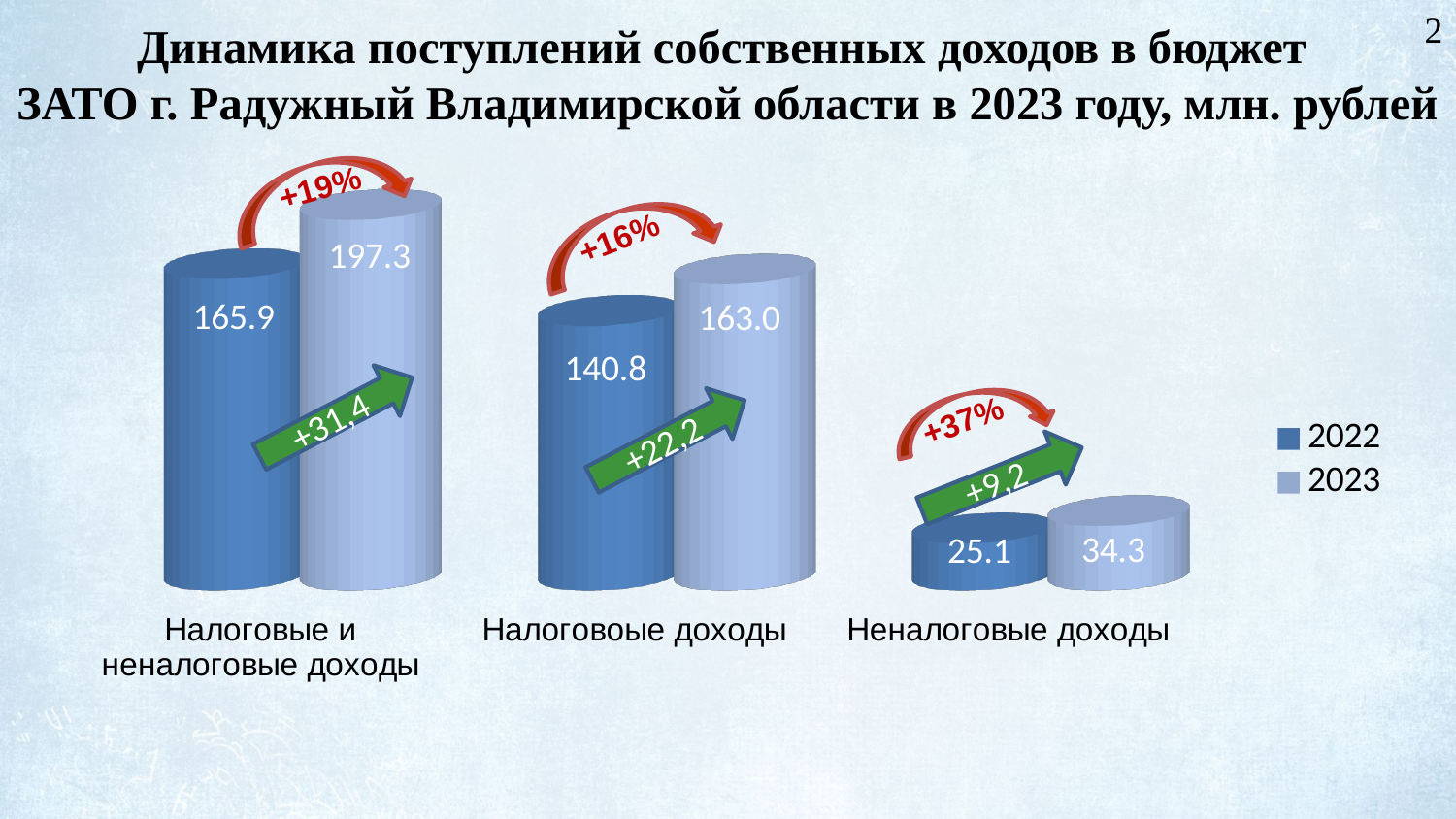
What kind of chart is shown on the slide? Bar chart What is the value for 2023 in the category "Неналоговые доходы"? 34.3 Which category has the highest value for 2023? Налоговые и неналоговые доходы Which is larger: the 2022 value for "Налоговые доходы" or the 2023 value for "Неналоговые доходы"? 2022 value for Налоговые доходы What is the value for 2022 in the category "Налоговые доходы"? 140.8 How many series does the legend list? 2 What is the difference between the 2023 and 2022 values for "Налоговые доходы"? 22.2 Which category has the lowest value for 2022? Неналоговые доходы What is the value for 2022 in the category "Неналоговые доходы"? 25.1 How many categories are shown on the x axis? 3 What is the value for 2023 in the category "Налоговые и неналоговые доходы"? 197.3 What percentage growth is annotated above the "Неналоговые доходы" category? +37%